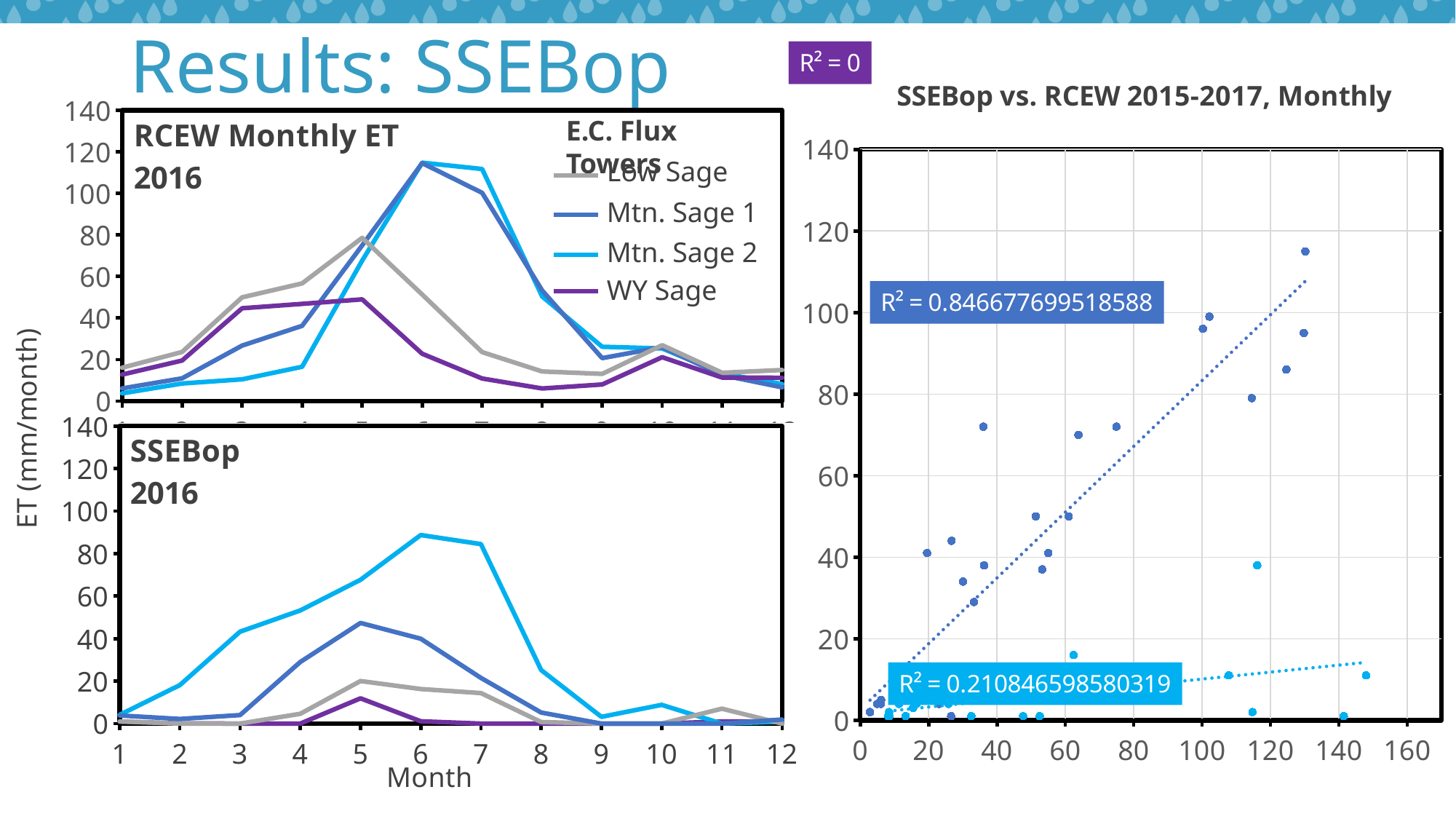
How many series does the legend of the "RCEW Monthly ET 2016" chart list? 4 How many months are shown on the x axis of the "SSEBop 2016" chart? 12 In the "SSEBop vs. RCEW 2015-2017, Monthly" chart, what R² value is shown in the dark blue label? R² = 0.846677699518588 In the "SSEBop 2016" chart, which series has the lowest peak value? WY Sage What kind of chart is the "RCEW Monthly ET 2016" chart? line chart In the "SSEBop 2016" chart, is the Mtn. Sage 2 value at month 6 greater or less than 80? greater In the "RCEW Monthly ET 2016" chart, is the WY Sage value at month 5 greater or less than 40? greater In the "SSEBop 2016" chart, does the Mtn. Sage 2 line rise or fall from month 7 to month 9? fall In the "SSEBop 2016" chart, which series reaches the highest peak value? Mtn. Sage 2 In the "RCEW Monthly ET 2016" chart, at month 5, which is higher: Low Sage or WY Sage? Low Sage In the "RCEW Monthly ET 2016" chart, is the Mtn. Sage 2 value at month 6 greater or less than 100? greater What kind of chart is the "SSEBop vs. RCEW 2015-2017, Monthly" chart on the right? scatter chart